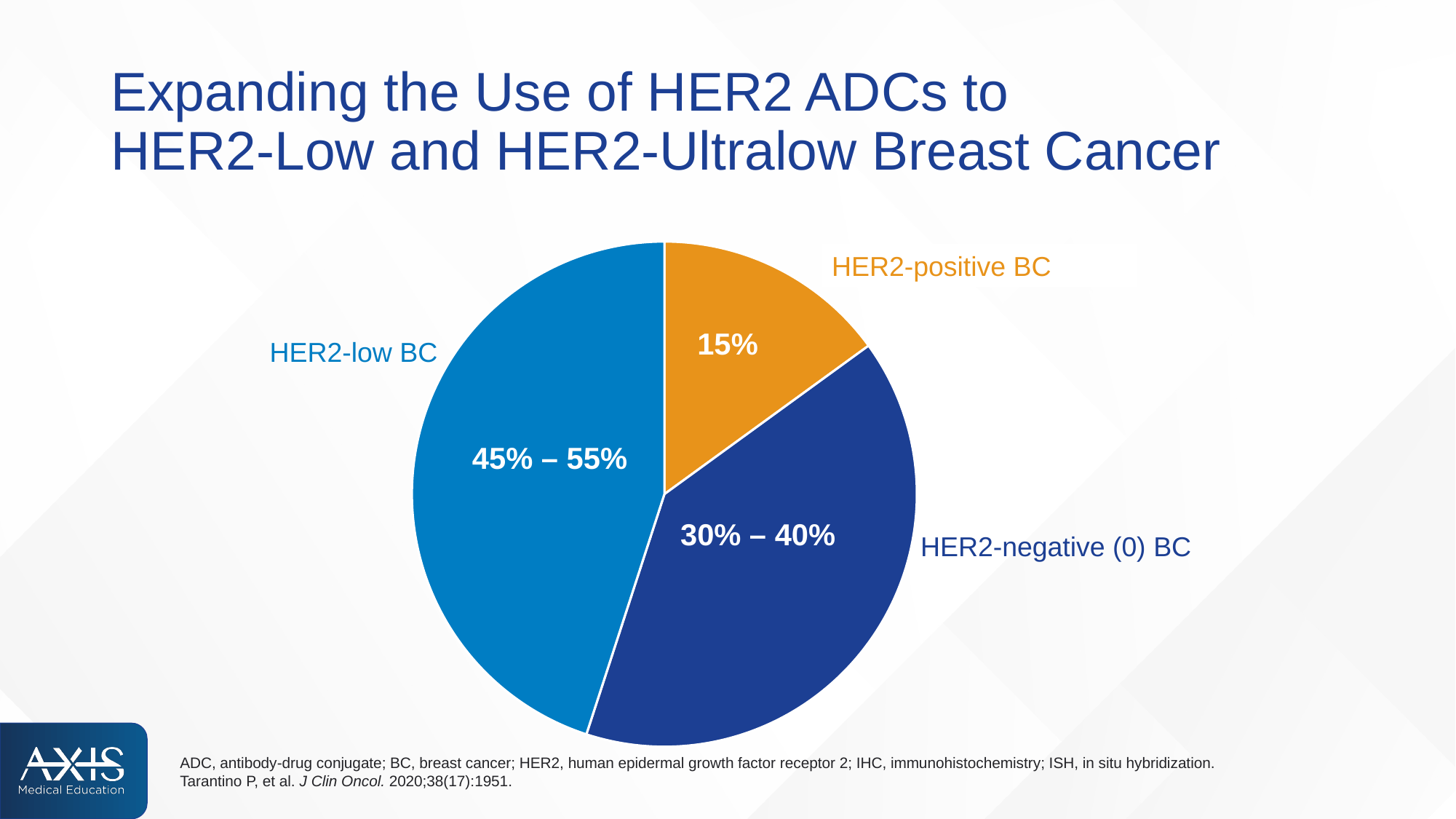
What share of the pie is labelled for HER2-positive BC? 15% What share of the pie is labelled for HER2-negative (0) BC? 30% – 40% What kind of chart is shown on the slide? Pie chart Which slice is larger, HER2-low BC or HER2-negative (0) BC? HER2-low BC Which slice is larger, HER2-negative (0) BC or HER2-positive BC? HER2-negative (0) BC What colour is the HER2-positive BC slice? Orange How many slices does the pie chart have? 3 What colour is the HER2-low BC slice? Light blue What share of the pie is labelled for HER2-low BC? 45% – 55% Which slice of the pie chart is the smallest? HER2-positive BC Which slice of the pie chart is the largest? HER2-low BC